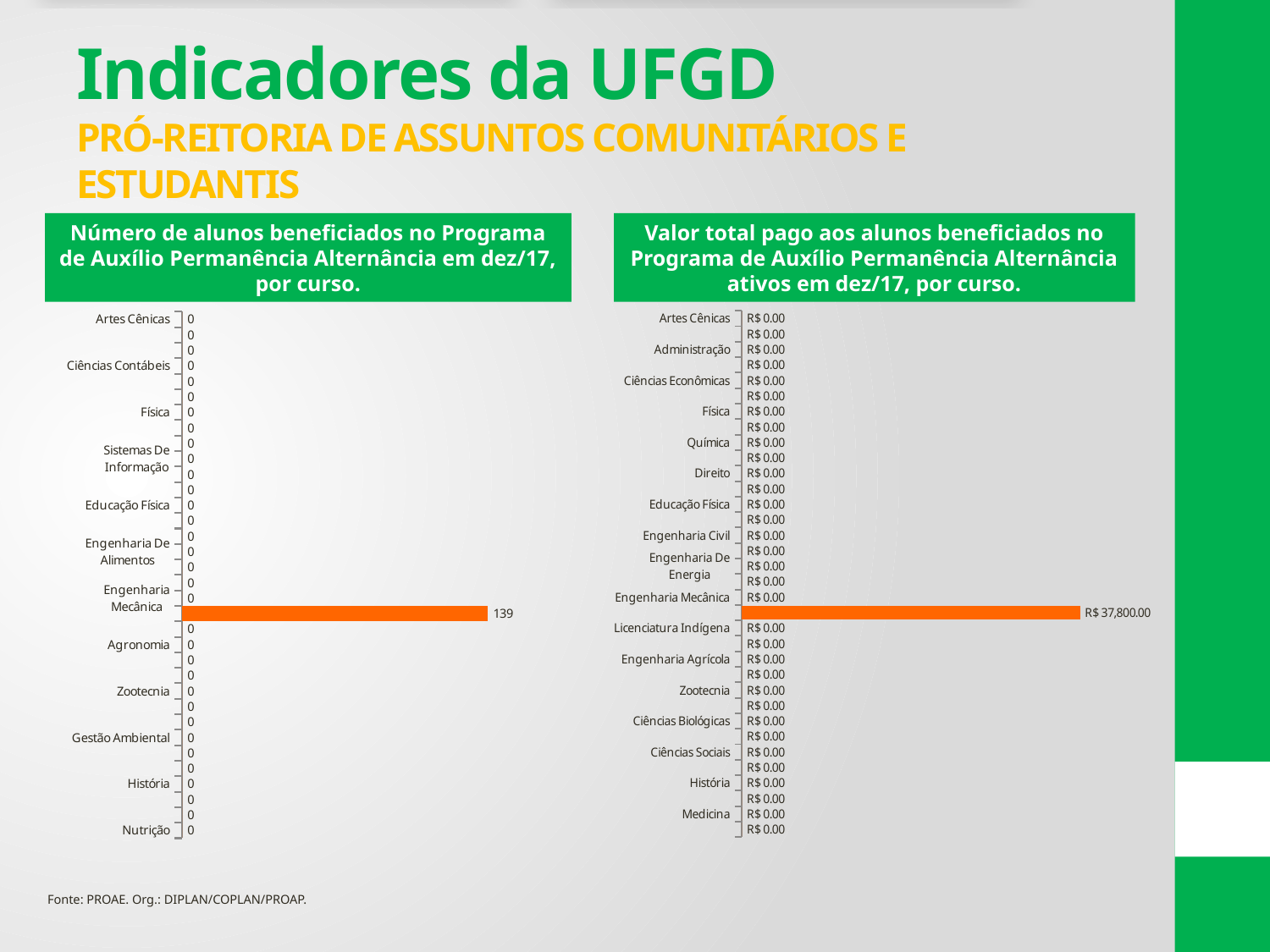
In the left chart (Número de alunos beneficiados), how many bars have a value other than 0? 1 In the right chart (Valor total pago), what is the largest value shown on any bar? R$ 37,800.00 In the right chart (Valor total pago), what is the value for Medicina? R$ 0.00 What colour are the bars in the two charts on the slide? Orange In the left chart (Número de alunos beneficiados), what is the value for Agronomia? 0 In the right chart (Valor total pago), how many bars have a value other than R$ 0.00? 1 In the left chart (Número de alunos beneficiados), what is the largest value shown on any bar? 139 In the right chart (Valor total pago), what is the value for Engenharia Mecânica? R$ 0.00 What kind of chart is the left chart, 'Número de alunos beneficiados no Programa de Auxílio Permanência Alternância em dez/17, por curso'? Bar chart What kind of chart is the right chart, 'Valor total pago aos alunos beneficiados no Programa de Auxílio Permanência Alternância ativos em dez/17, por curso'? Bar chart In the left chart (Número de alunos beneficiados), what is the value for Zootecnia? 0 In the left chart (Número de alunos beneficiados), what is the value for Física? 0